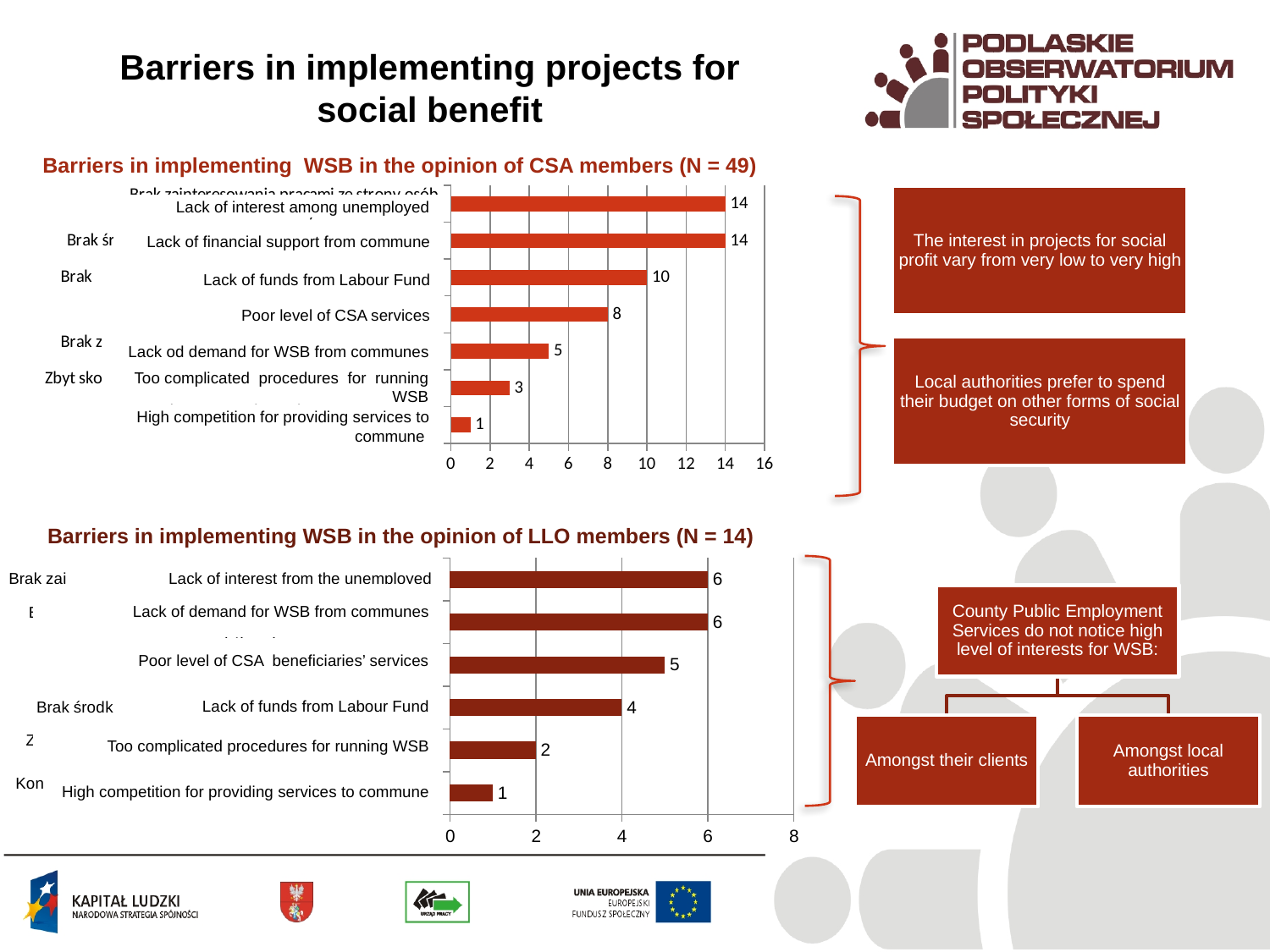
In the chart 'Barriers in implementing WSB in the opinion of LLO members (N = 14)', what is the difference between 'Lack of interest from the unemployed' and 'High competition for providing services to commune'? 5 In the chart 'Barriers in implementing WSB in the opinion of CSA members (N = 49)', what is the value for 'Lack of funds from Labour Fund'? 10 In the chart 'Barriers in implementing WSB in the opinion of LLO members (N = 14)', which is larger: 'Poor level of CSA beneficiaries' services' or 'Lack of funds from Labour Fund'? Poor level of CSA beneficiaries' services In the chart 'Barriers in implementing WSB in the opinion of CSA members (N = 49)', what is the difference between 'Lack of financial support from commune' and 'Lack od demand for WSB from communes'? 9 In the chart 'Barriers in implementing WSB in the opinion of LLO members (N = 14)', what is the value for 'Lack of funds from Labour Fund'? 4 In the chart 'Barriers in implementing WSB in the opinion of CSA members (N = 49)', how many categories are shown? 7 What type of chart is 'Barriers in implementing WSB in the opinion of CSA members (N = 49)'? Bar chart In the chart 'Barriers in implementing WSB in the opinion of CSA members (N = 49)', is the value for 'Too complicated procedures for running WSB' greater or less than 4? less In the chart 'Barriers in implementing WSB in the opinion of CSA members (N = 49)', what is the value for 'Poor level of CSA services'? 8 In the chart 'Barriers in implementing WSB in the opinion of CSA members (N = 49)', which category has the lowest value? High competition for providing services to commune In the chart 'Barriers in implementing WSB in the opinion of LLO members (N = 14)', how many categories are shown? 6 In the chart 'Barriers in implementing WSB in the opinion of LLO members (N = 14)', what is the value for 'Too complicated procedures for running WSB'? 2